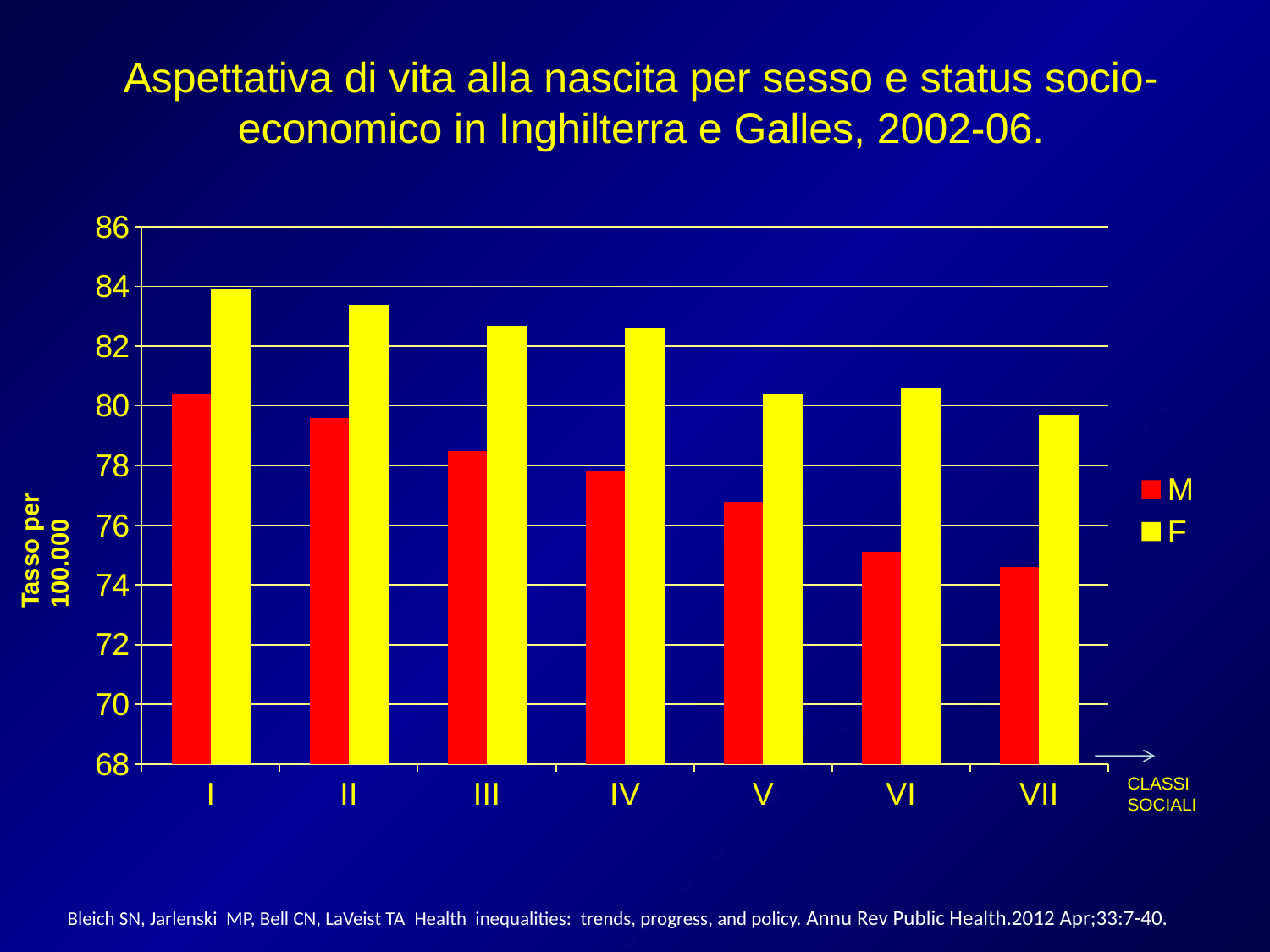
Which social class has the highest value for series M? I Is the value for series M in social class VI greater or less than 76? less For social class I, which series has the larger value, M or F? F Do the values for series M rise or fall from social class I to social class VII? fall How many social classes (categories) are shown on the x axis? 7 Which social class has the lowest value for series M? VII What kind of chart is shown on the slide? bar chart Which social class has the lowest value for series F? VII What are the two entries listed in the legend? M and F Which social class has the highest value for series F? I How many series does the legend list? 2 Is the value for series F in social class III greater or less than 82? greater